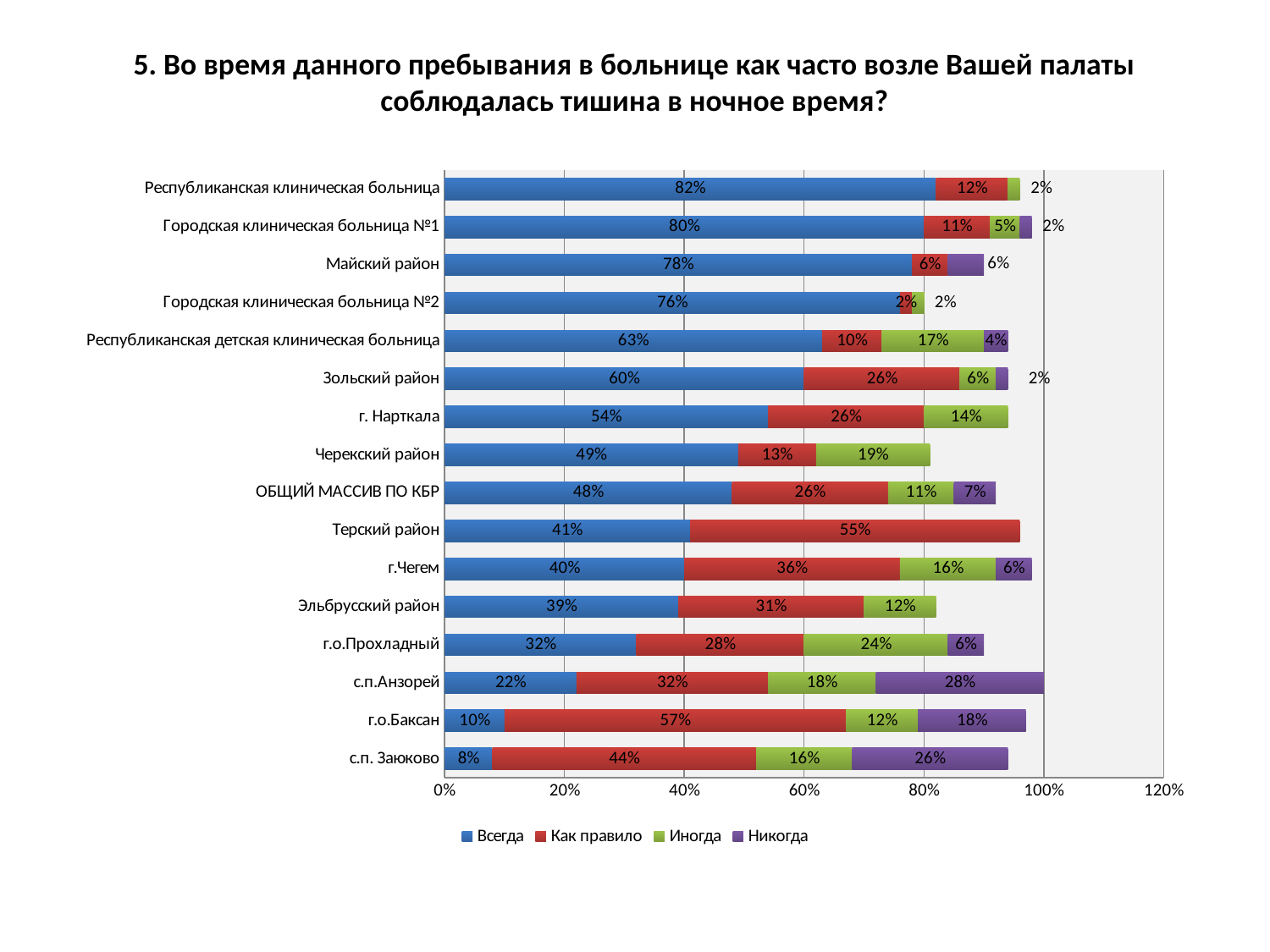
What is the 'Никогда' value for с.п.Анзорей? 28% What is the 'Иногда' value for г.о.Прохладный? 24% What is the 'Как правило' value for г.о.Баксан? 57% How many series does the legend list? 4 What is the total of the stacked bar for с.п.Анзорей? 100% How many categories are shown on the chart? 16 What is the 'Всегда' value for Республиканская клиническая больница? 82% Which category has the lowest 'Всегда' value? с.п. Заюково Which category has the highest 'Всегда' value? Республиканская клиническая больница What is the difference between the 'Всегда' values for Терский район and г.Чегем? 1% What kind of chart is shown on the slide? Stacked bar chart Which is larger: the 'Как правило' value for Терский район or for с.п. Заюково? Терский район